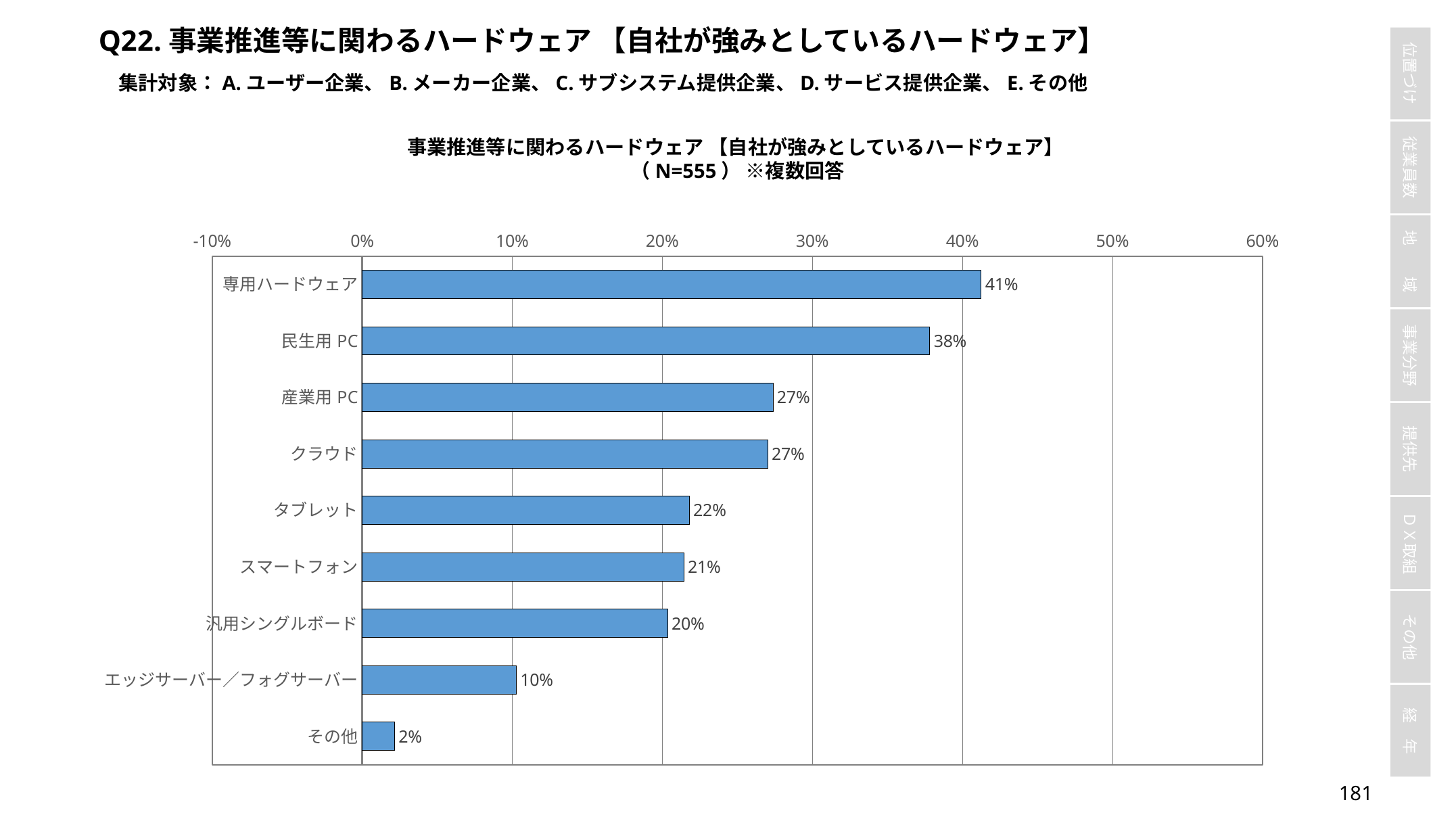
What is the value for 専用ハードウェア? 41% What is the value for 民生用PC? 38% What is the difference between the values for 専用ハードウェア and 民生用PC? 3% What is the N value shown in the chart title? N=555 How many categories are shown in the chart? 9 What is the value for エッジサーバー／フォグサーバー? 10% Which category has the lowest value? その他 Which category has the highest value? 専用ハードウェア What kind of chart is shown on the slide? bar chart Is the value for 産業用PC greater or less than 20%? greater Which is larger, the value for タブレット or the value for エッジサーバー／フォグサーバー? タブレット What is the value for 汎用シングルボード? 20%